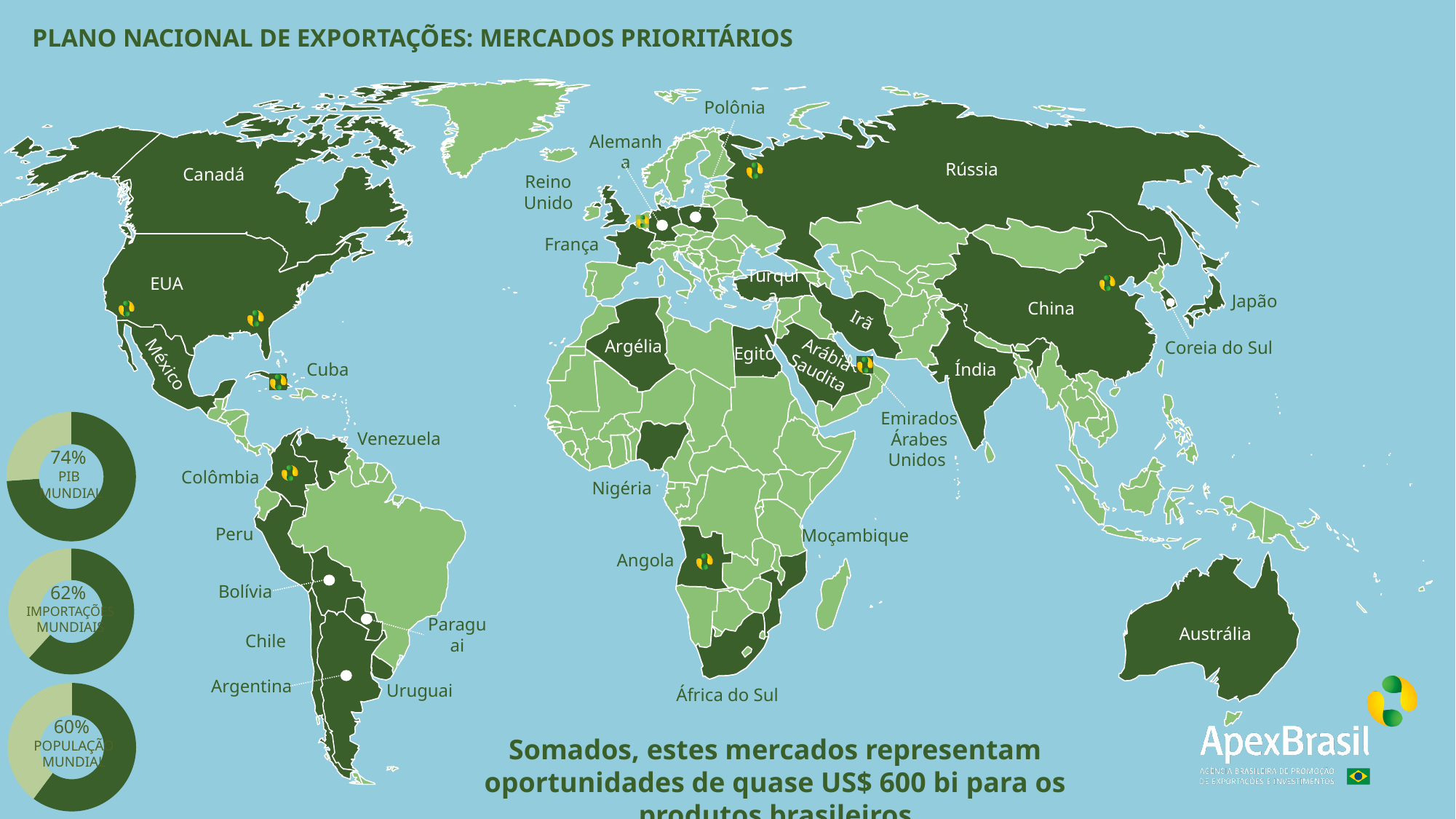
What is the title of the slide? PLANO NACIONAL DE EXPORTAÇÕES: MERCADOS PRIORITÁRIOS What is the difference between the percentage in the PIB Mundial doughnut chart and the percentage in the Importações Mundiais doughnut chart? 12 percentage points In the middle doughnut chart on the left (Importações Mundiais), what percentage is shown? 62% In the top doughnut chart on the left, is the value for PIB Mundial greater or less than 70%? greater In the bottom doughnut chart on the left (População Mundial), what percentage is shown? 60% Among the three doughnut charts on the left, which one shows the highest percentage? PIB Mundial (74%) What kind of charts are the three small charts on the left side of the slide? Doughnut (pie) charts Which is larger: the percentage in the Importações Mundiais doughnut chart or the percentage in the População Mundial doughnut chart? Importações Mundiais How many doughnut charts are shown on the left side of the slide? 3 What is the difference between the percentage in the PIB Mundial doughnut chart and the percentage in the População Mundial doughnut chart? 14 percentage points Among the three doughnut charts on the left, which one shows the lowest percentage? População Mundial (60%) In the top doughnut chart on the left (PIB Mundial), what percentage is shown? 74%